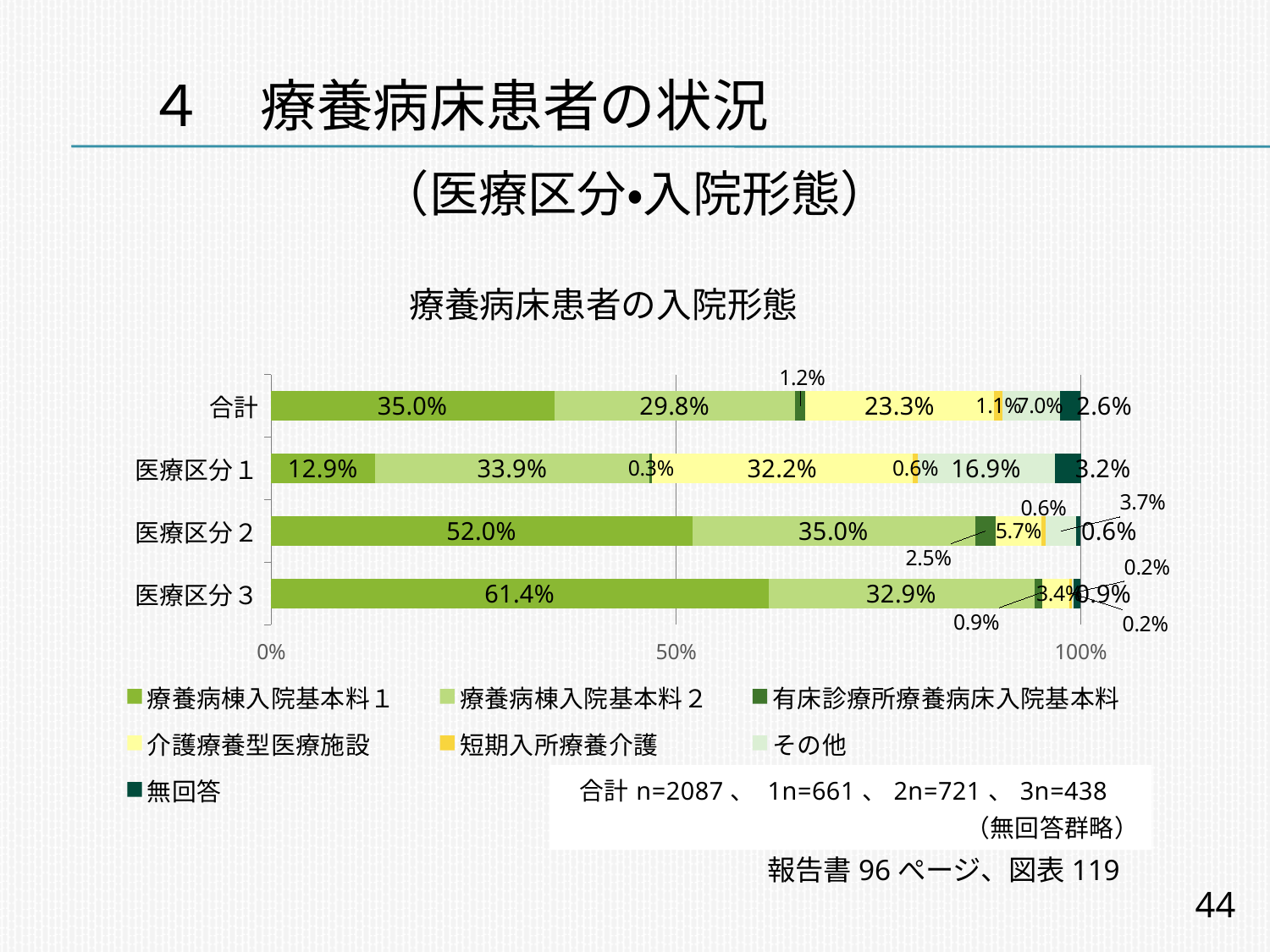
Which is larger: the 療養病棟入院基本料２ value for 医療区分２ or for 医療区分３? 医療区分２ How many series does the legend list? 7 What is the value of その他 for 合計? 7.0% How many categories are shown on the vertical axis? 4 What is the difference between the 療養病棟入院基本料１ values for 医療区分３ and 医療区分１? 48.5 percentage points What is the value of 療養病棟入院基本料２ for 医療区分１? 33.9% What is the value of 無回答 for 医療区分１? 3.2% What is the value of 介護療養型医療施設 for 医療区分１? 32.2% Which category has the highest value for 療養病棟入院基本料１? 医療区分３ What is the value of 療養病棟入院基本料１ for 合計? 35.0% What kind of chart is shown? Stacked bar chart Which category has the lowest value for 療養病棟入院基本料１? 医療区分１